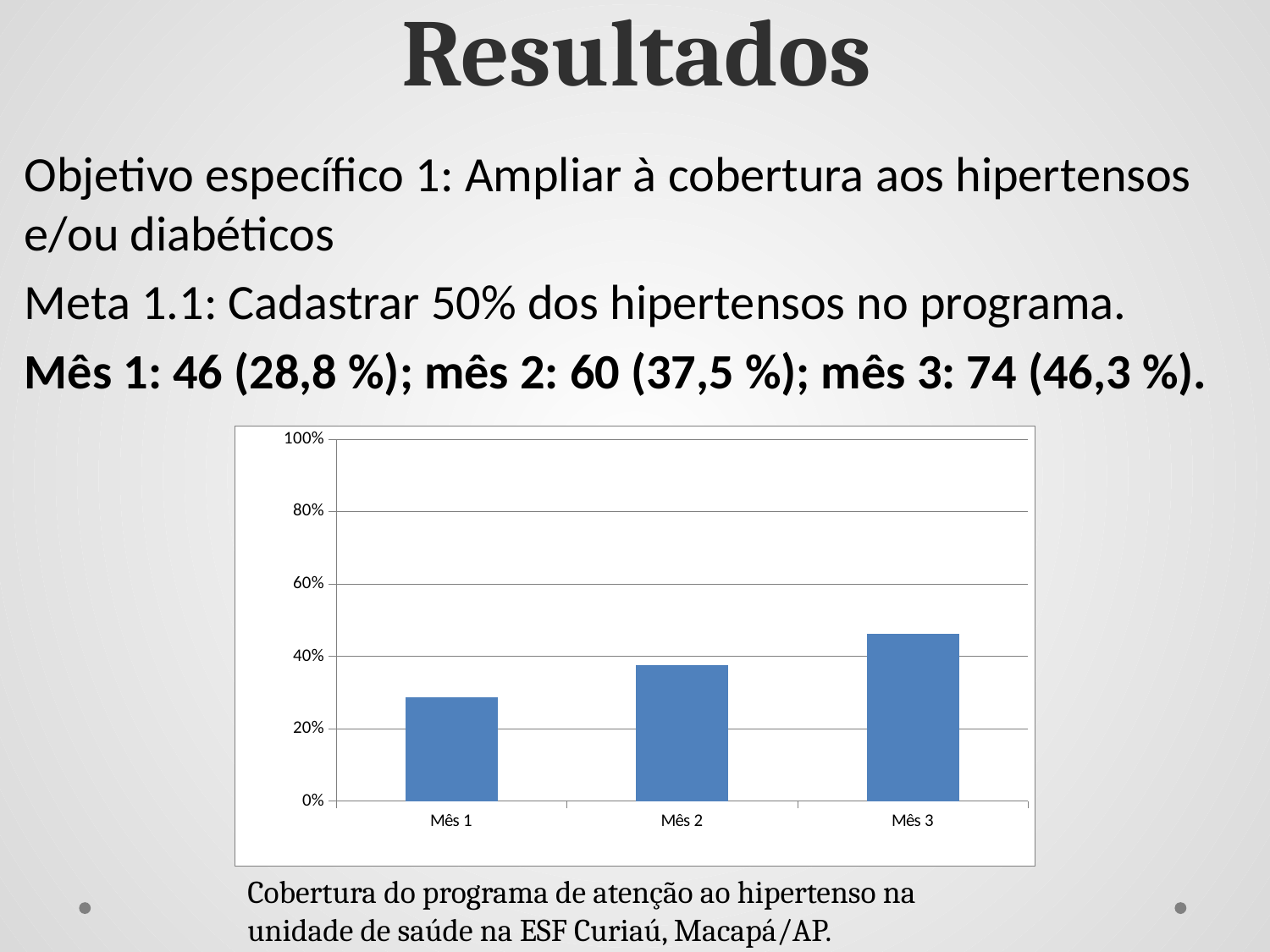
Is the value for Mês 3 greater or less than 40%? greater Is the value for Mês 2 greater or less than 20%? greater Do the values rise or fall from Mês 1 to Mês 3? rise Which is larger, the bar for Mês 1 or the bar for Mês 2? Mês 2 What kind of chart is shown on the slide? bar chart Which month has the lowest bar in the chart? Mês 1 Is the value for Mês 3 greater or less than 60%? less What colour are the bars in the chart? blue How many categories (months) are plotted on the chart? 3 What is the highest value shown on the vertical axis of the chart? 100% Which month has the highest bar in the chart? Mês 3